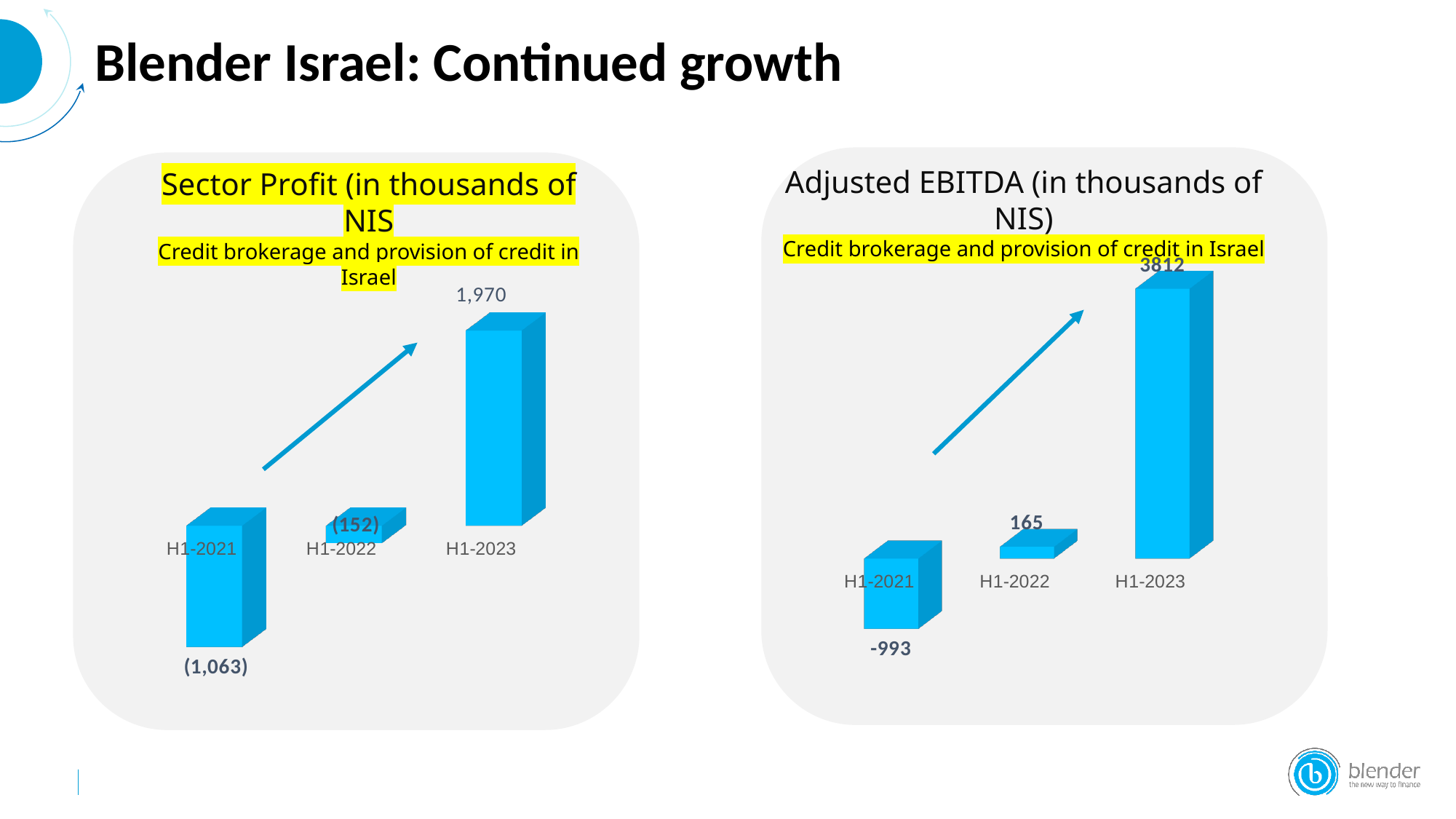
In the Adjusted EBITDA chart, how much higher is the H1-2023 value than the H1-2022 value? 3647 In the Sector Profit chart, what is the value for H1-2022? (152) What type of chart is the Adjusted EBITDA chart? Bar chart In the Sector Profit chart, what is the value for H1-2021? (1,063) In the Adjusted EBITDA chart, what is the value for H1-2023? 3812 In the Sector Profit chart, which period has the highest value? H1-2023 In the Adjusted EBITDA chart, which period has the lowest value? H1-2021 In the Adjusted EBITDA chart, do the values rise or fall from H1-2021 to H1-2023? Rise In the Sector Profit chart, how many periods are shown? 3 In the Sector Profit chart, what is the value for H1-2023? 1,970 In the Adjusted EBITDA chart, what is the value for H1-2022? 165 In the Adjusted EBITDA chart, what is the value for H1-2021? -993